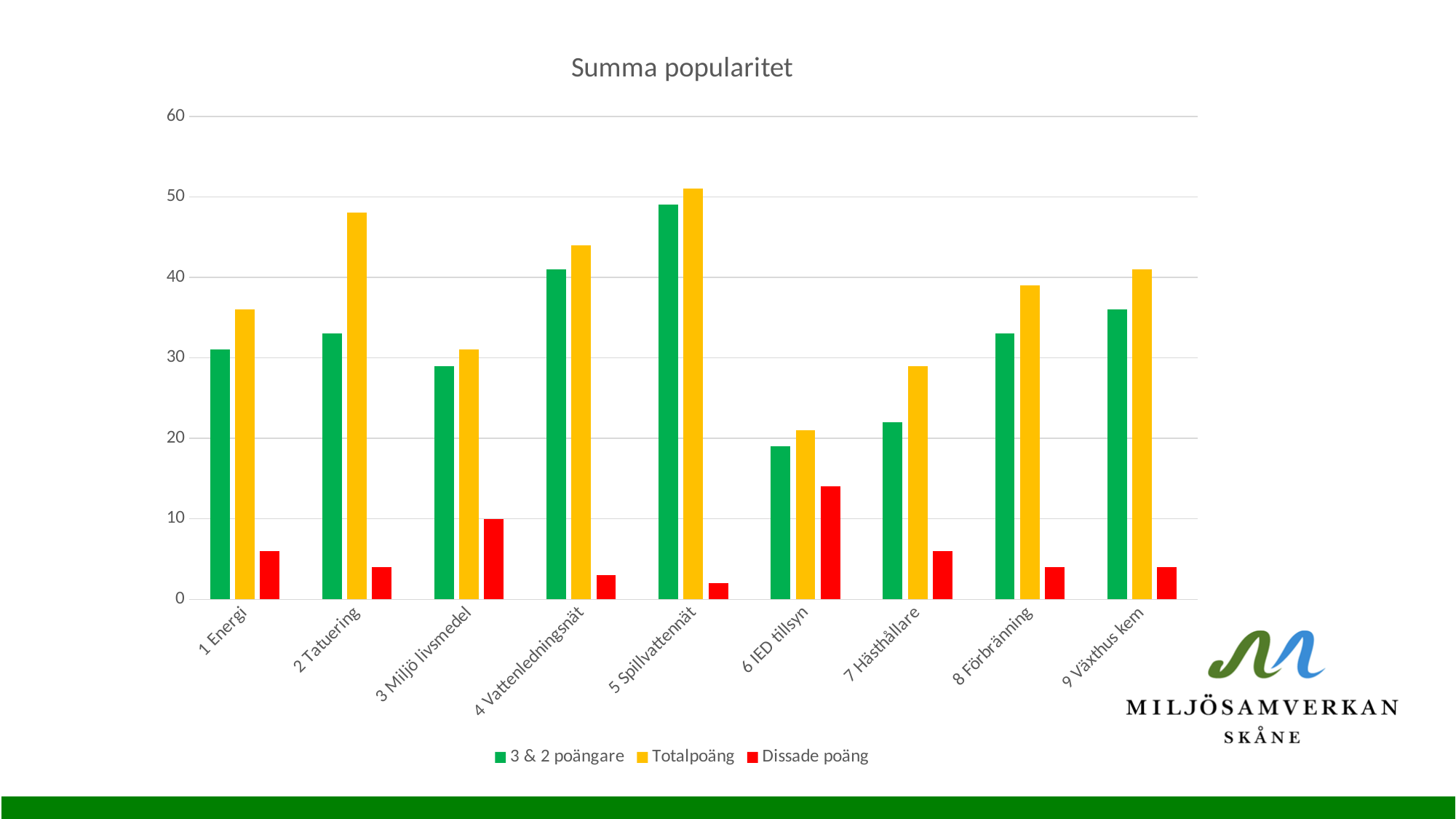
Is the Totalpoäng value for 1 Energi greater or less than 40? less What kind of chart is shown on the slide? bar chart Is the Totalpoäng value for 2 Tatuering greater or less than 40? greater What is the Dissade poäng value for 3 Miljö livsmedel? 10 Which category has the highest Dissade poäng value? 6 IED tillsyn How many series does the legend list? 3 Which category has the highest Totalpoäng value? 5 Spillvattennät Which is larger: the Totalpoäng value for 2 Tatuering or for 4 Vattenledningsnät? 2 Tatuering How many categories are shown on the x axis? 9 Which category has the lowest Totalpoäng value? 6 IED tillsyn Which category has the highest value for 3 & 2 poängare? 5 Spillvattennät What is the title of the chart? Summa popularitet